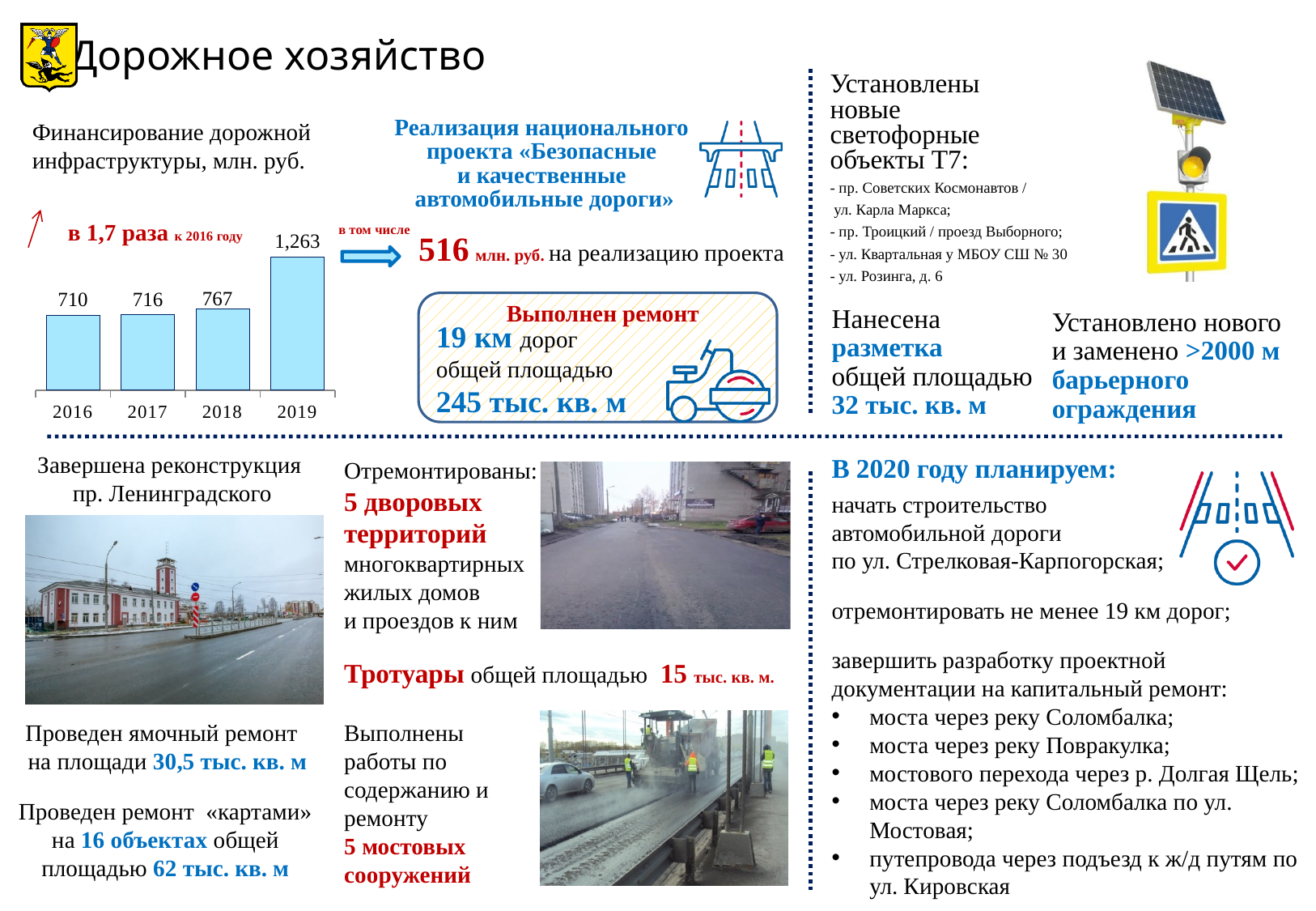
What is the value for 2019 in the chart 'Финансирование дорожной инфраструктуры, млн. руб.'? 1,263 What unit is stated in the title of the road infrastructure financing chart? млн. руб. In the road infrastructure financing chart, which is larger: the value for 2018 or the value for 2017? 2018 Do the values in the road infrastructure financing chart rise or fall from 2016 to 2019? rise What kind of chart is used to show road infrastructure financing? bar chart Which year has the highest value in the road infrastructure financing chart? 2019 What is the value for 2018 in the road infrastructure financing chart? 767 What is the difference between the 2017 and 2016 values in the road infrastructure financing chart? 6 Which year has the lowest value in the road infrastructure financing chart? 2016 How many years are shown in the road infrastructure financing chart? 4 What is the difference between the 2019 and 2018 values in the road infrastructure financing chart? 496 What is the value for 2016 in the road infrastructure financing chart? 710